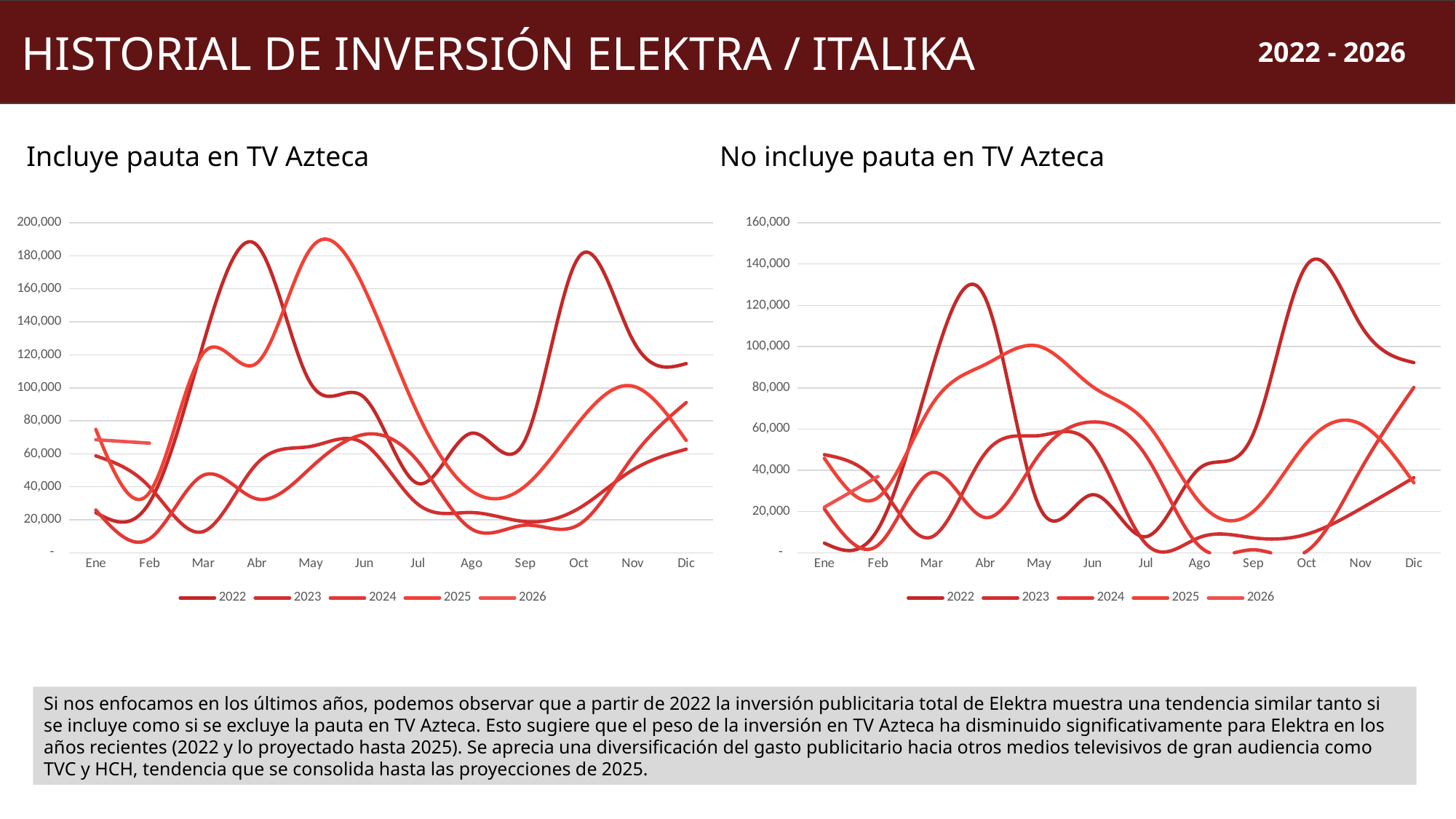
On the left chart 'Incluye pauta en TV Azteca', is the highest value reached by any line greater or less than 180,000? greater How many categories are shown on the x axis of the right chart 'No incluye pauta en TV Azteca'? 12 How many series does the legend of the left chart 'Incluye pauta en TV Azteca' list? 5 How many series does the legend of the right chart 'No incluye pauta en TV Azteca' list? 5 What is the highest value shown on the y axis of the left chart 'Incluye pauta en TV Azteca'? 200,000 On the right chart 'No incluye pauta en TV Azteca', is the highest value reached by any line greater or less than 120,000? greater What kind of chart is the right chart titled 'No incluye pauta en TV Azteca'? line chart How many categories are shown on the x axis of the left chart 'Incluye pauta en TV Azteca'? 12 On the right chart 'No incluye pauta en TV Azteca', is the highest value reached by any line greater or less than 160,000? less What is the title of the chart on the right side of the slide? No incluye pauta en TV Azteca What kind of chart is the left chart titled 'Incluye pauta en TV Azteca'? line chart